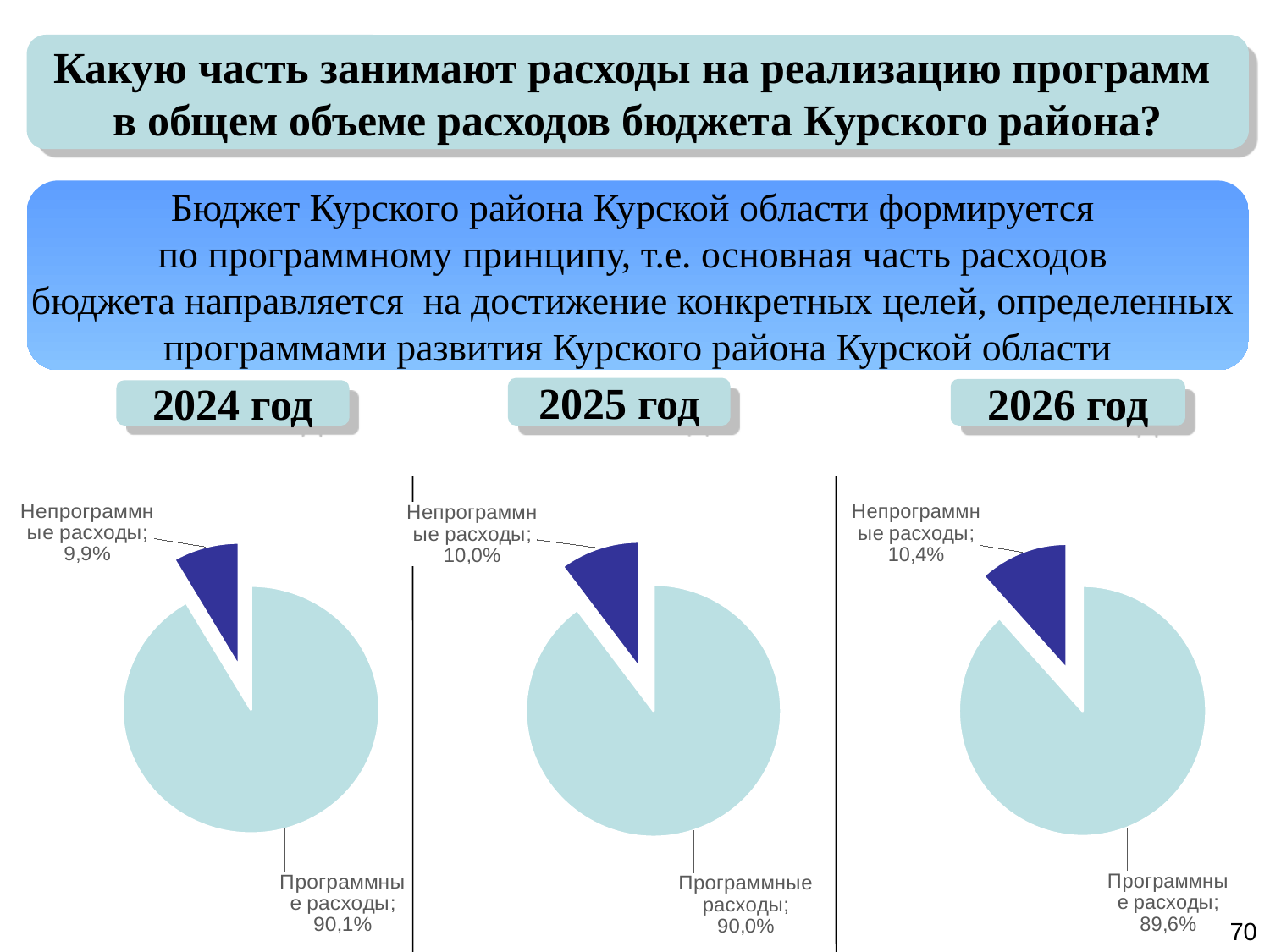
In the 2025 год pie chart, what share is labelled for Непрограммные расходы? 10,0% What kind of chart is used for each of the three years on the slide? Pie chart How many slices does the 2024 год pie chart have? 2 In the 2025 год pie chart, what share is labelled for Программные расходы? 90,0% In the 2026 год pie chart, what share is labelled for Программные расходы? 89,6% In the 2024 год pie chart, what share is labelled for Непрограммные расходы? 9,9% Across the three pie charts, which year has the highest share for Непрограммные расходы? 2026 год In the 2024 год pie chart, what share is labelled for Программные расходы? 90,1% Across the three pie charts, which year has the lowest share for Непрограммные расходы? 2024 год In the 2026 год pie chart, what share is labelled for Непрограммные расходы? 10,4% What is the difference between the Программные расходы share in the 2024 год chart and in the 2026 год chart? 0,5% In the 2026 год pie chart, which slice is larger: Программные расходы or Непрограммные расходы? Программные расходы